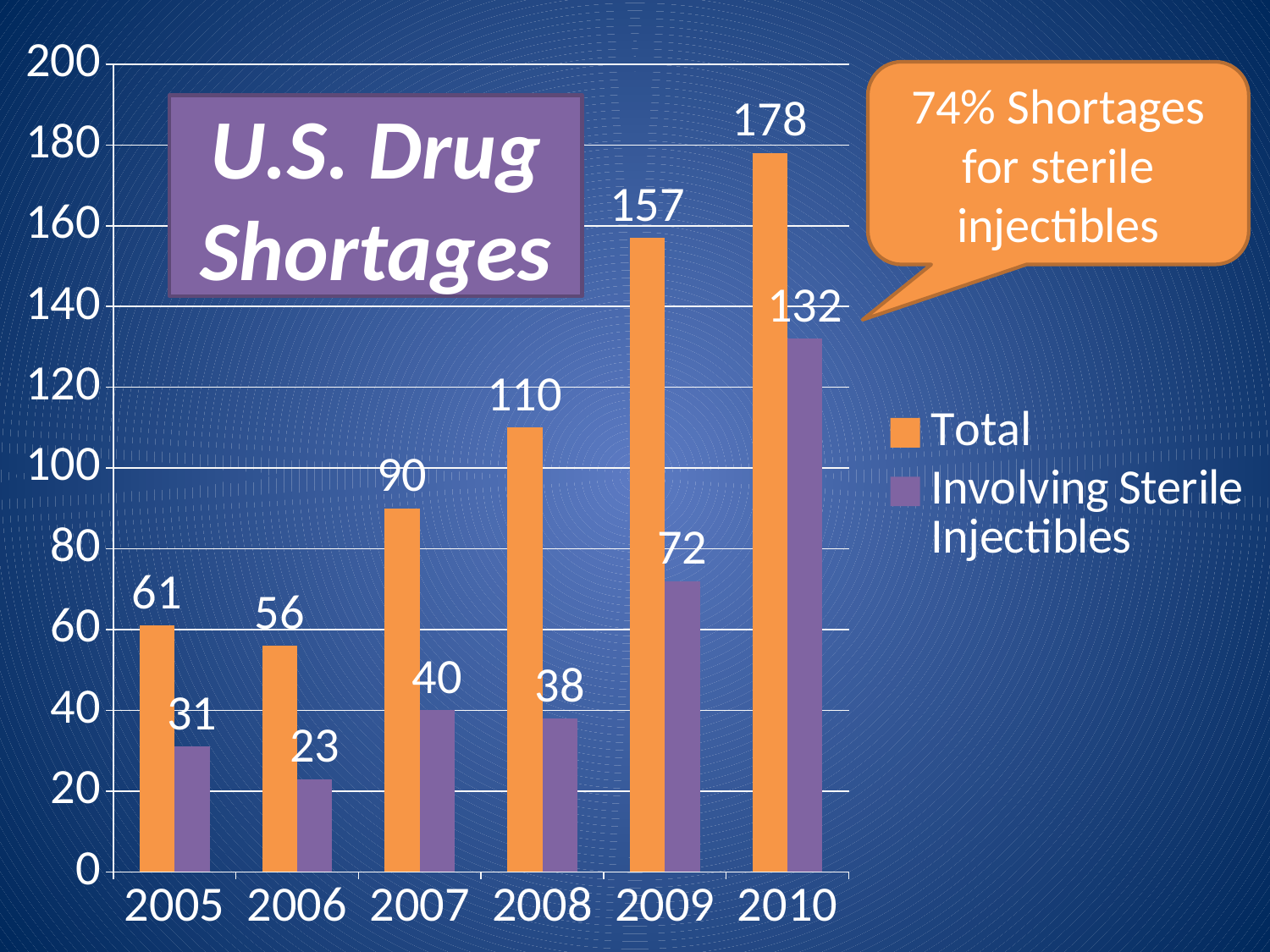
How many series does the legend list? 2 What is the Total value for 2010? 178 Which year has the highest Total value? 2010 What colour are the bars for the Total series? Orange What kind of chart is shown on the slide? Bar chart Which is larger, the Involving Sterile Injectables value for 2007 or for 2008? 2007 Which year has the lowest Involving Sterile Injectables value? 2006 Does the Total value rise or fall from 2006 to 2010? Rise What is the Involving Sterile Injectables value for 2007? 40 How many years are shown on the x axis? 6 What is the difference between the Total and Involving Sterile Injectables values for 2009? 85 What is the title of the chart? U.S. Drug Shortages